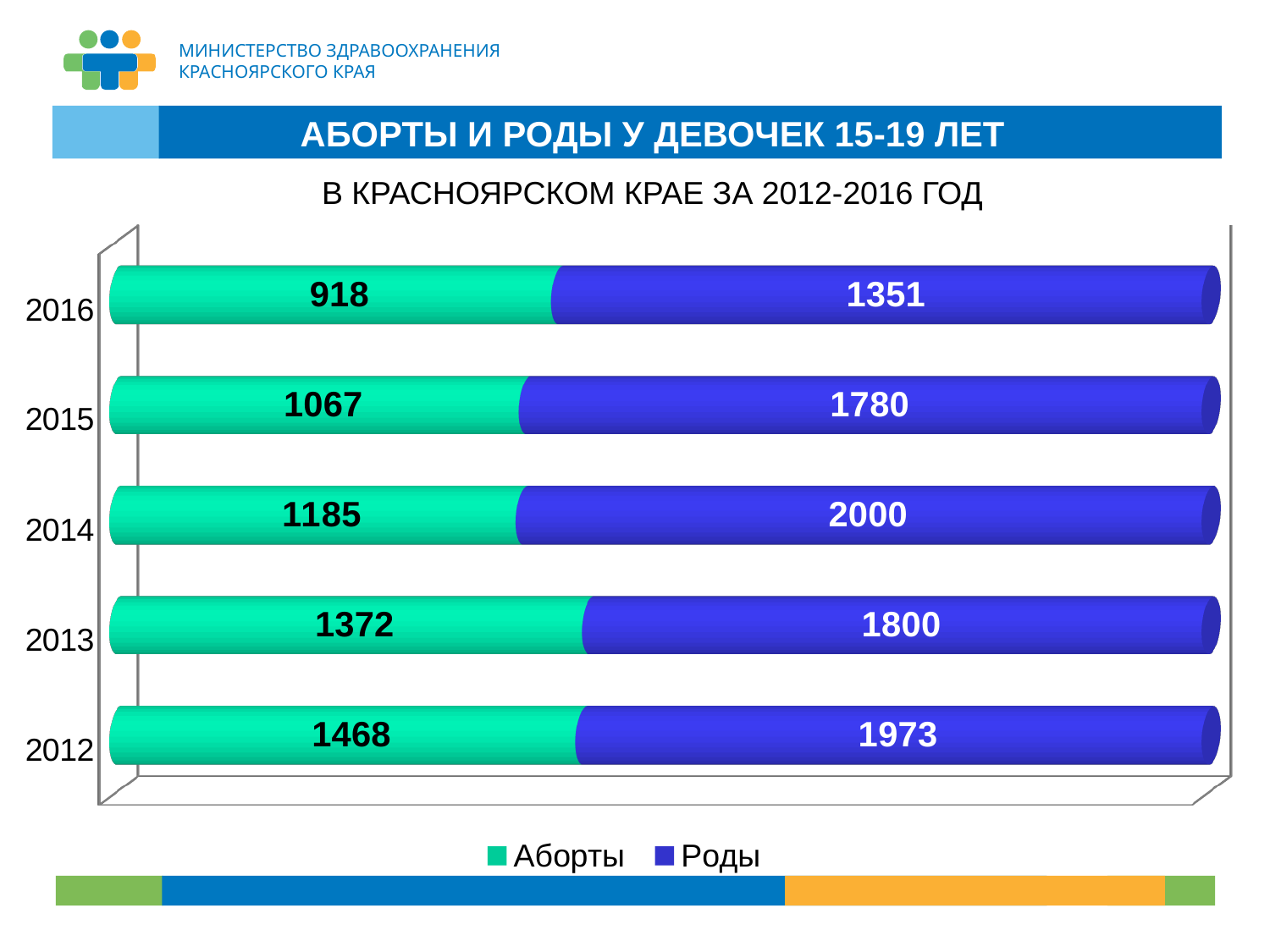
How many years are shown on the chart? 5 Which year has the highest value for Аборты? 2012 What is the value for Роды in 2012? 1973 What is the value for Роды in 2014? 2000 Does the value for Аборты rise or fall from 2012 to 2016? Fall Which is larger in 2013: Аборты or Роды? Роды How many series does the legend list? 2 Which year has the lowest value for Роды? 2016 What is the value for Аборты in 2016? 918 What is the difference between Роды and Аборты in 2015? 713 What is the total of Аборты and Роды for 2014? 3185 What kind of chart is shown on the slide? Stacked bar chart